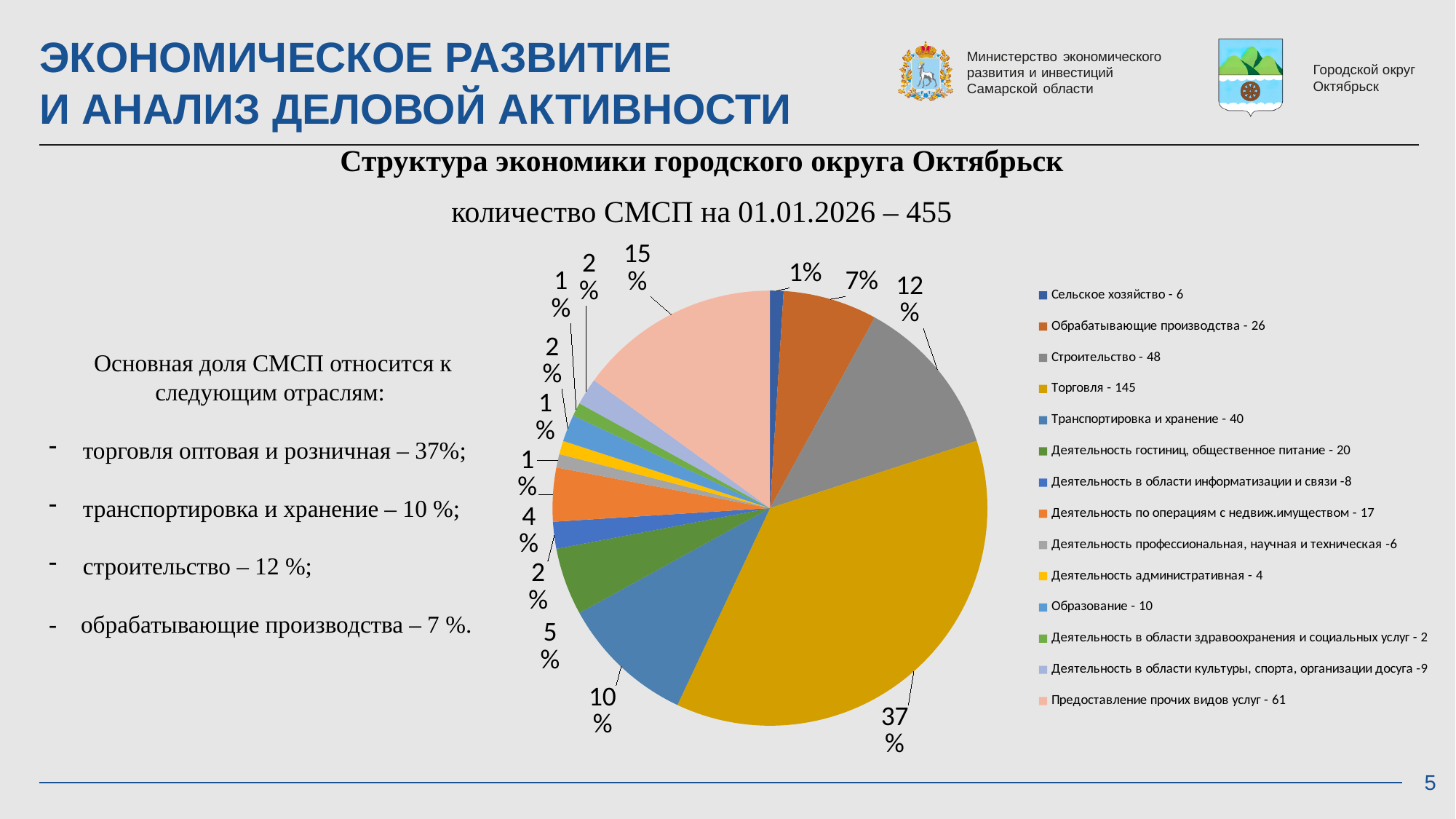
What share of the pie does Строительство represent? 12% What is the value for Транспортировка и хранение according to the legend? 40 What is the title of the chart? Структура экономики городского округа Октябрьск What share of the pie does Торговля represent? 37% What is the difference between the values for Торговля and Строительство? 97 Which category has the largest slice of the pie chart? Торговля What kind of chart is shown on the slide? pie chart What is the value for Строительство according to the legend? 48 How many categories does the pie chart have? 14 Which category has the smallest slice of the pie chart? Деятельность в области здравоохранения и социальных услуг Which is larger, Обрабатывающие производства or Деятельность гостиниц, общественное питание? Обрабатывающие производства What share of the pie does Предоставление прочих видов услуг represent? 15%